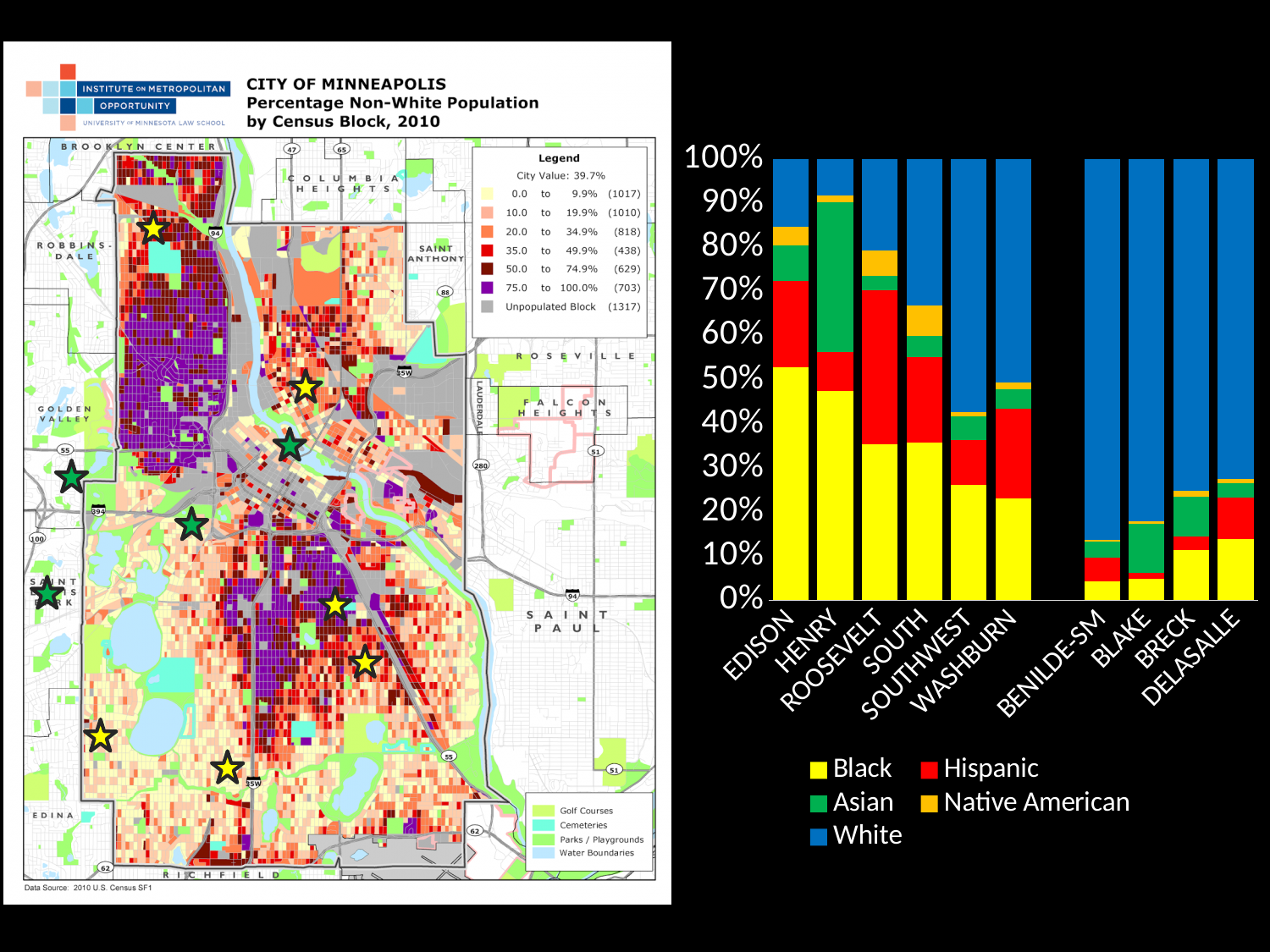
Which colour represents Native American in the bar chart legend? orange Is the Asian share for HENRY greater or less than 30%? greater What does each stacked bar in the chart total? 100% Is the White share for BENILDE-SM greater or less than 80%? greater Is the Black share for WASHBURN greater or less than 30%? less How many schools are shown along the x axis of the bar chart? 10 Which school has a larger Black share, EDISON or WASHBURN? EDISON Which school has the highest share of Black students in the bar chart? EDISON How many series does the legend of the bar chart list? 5 Which school has the lowest share of White students in the bar chart? HENRY Which school has a larger Asian share, HENRY or ROOSEVELT? HENRY What kind of chart is shown on the right side of the slide? stacked bar chart